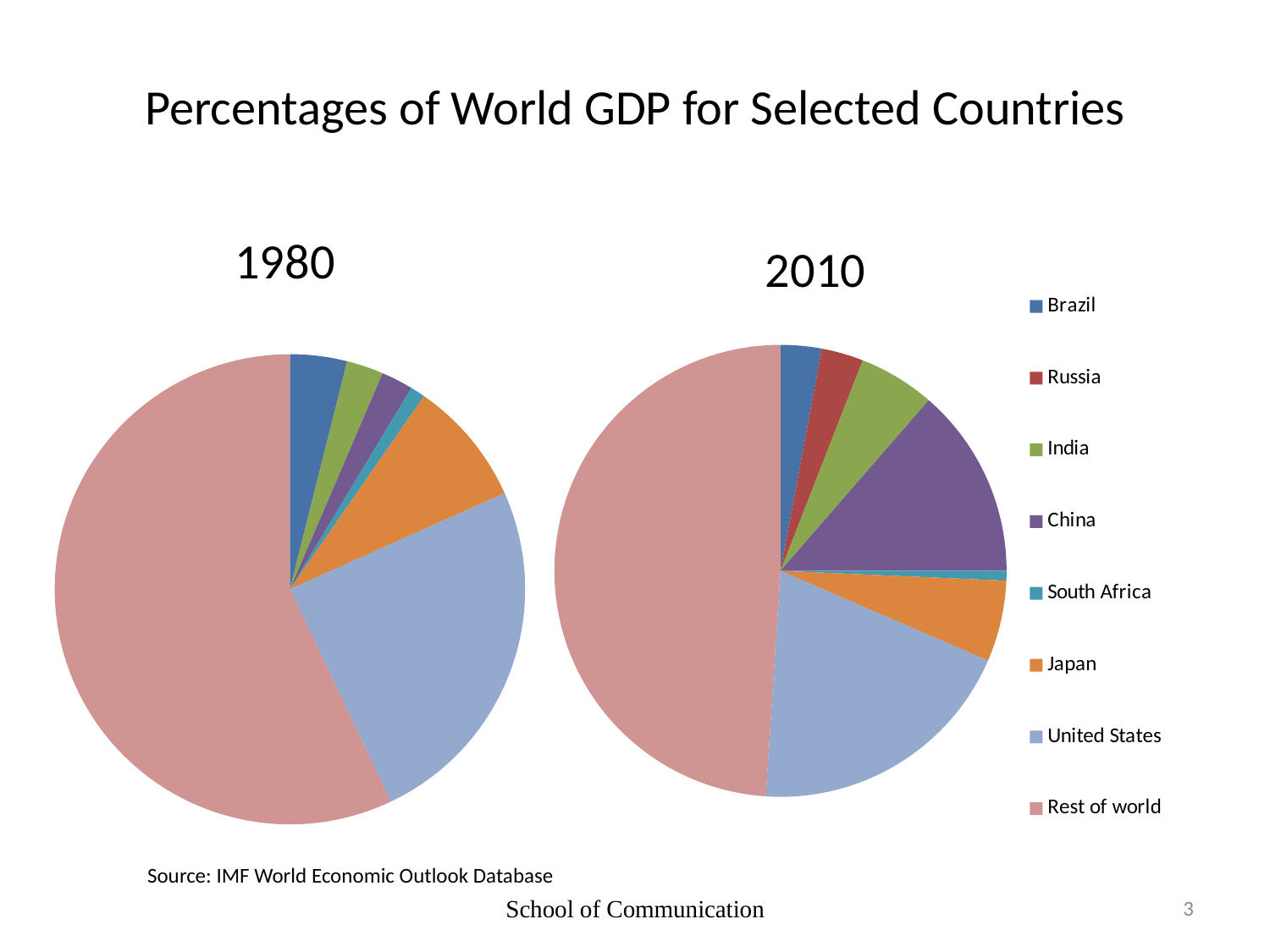
What colour represents China in the legend? Purple What is the title of the slide? Percentages of World GDP for Selected Countries In the 2010 pie chart, which category has the largest slice? Rest of world Is China's share of world GDP larger in the 1980 pie chart or the 2010 pie chart? 2010 In the 1980 pie chart, which slice is larger, Japan or China? Japan In the 1980 pie chart, which slice is larger, United States or Japan? United States What kind of charts are shown on the slide? Pie charts In the 1980 pie chart, which category has the largest slice? Rest of world How many entries does the legend list? 8 In the 2010 pie chart, which category has the smallest slice? South Africa